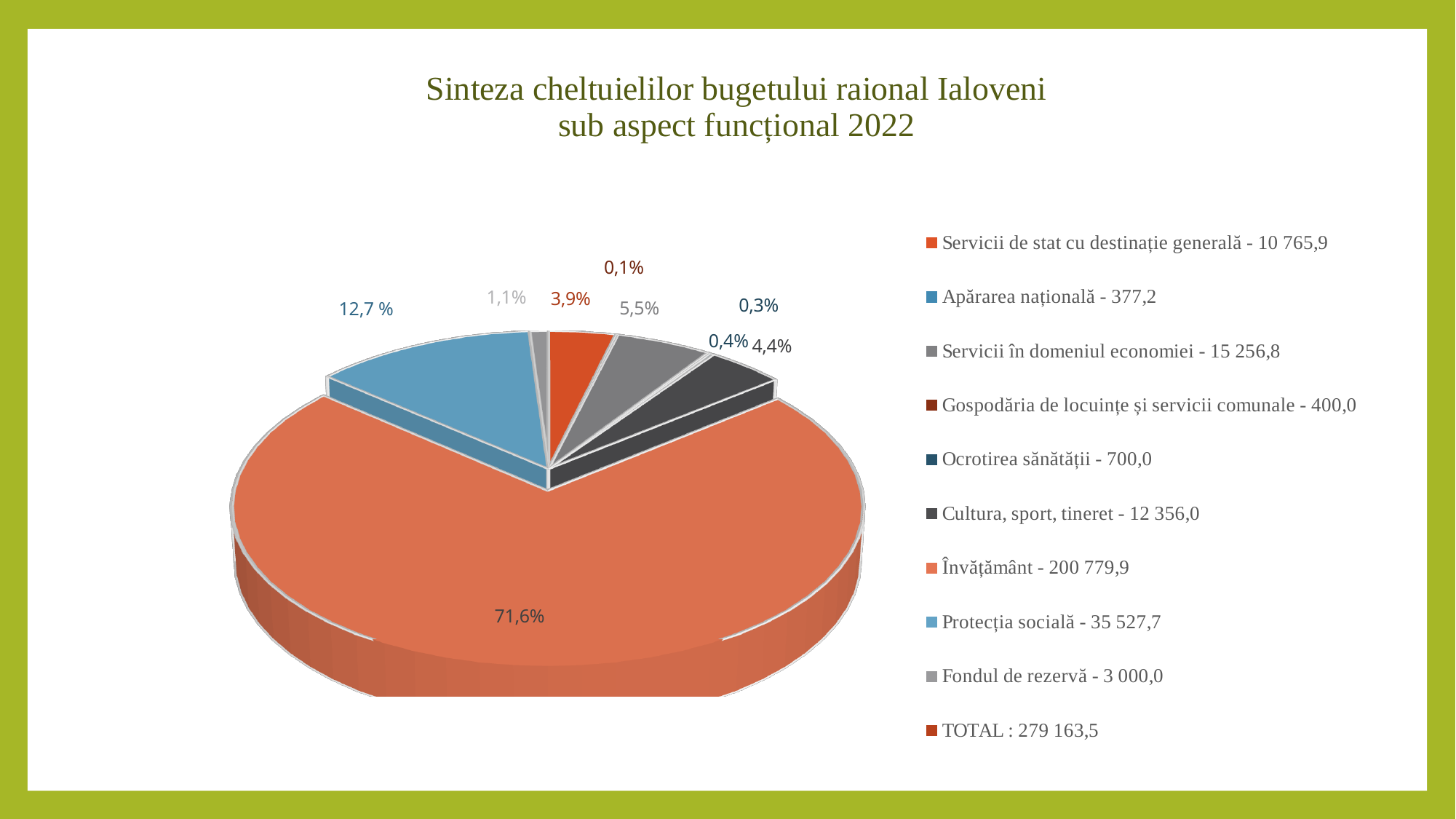
Which category has the smallest value in the legend? Apărarea națională What value is listed in the legend for Cultura, sport, tineret? 12 356,0 Which is larger: Servicii în domeniul economiei or Servicii de stat cu destinație generală? Servicii în domeniul economiei What percentage is shown on the largest slice of the pie? 71,6% What value is listed in the legend for Fondul de rezervă? 3 000,0 How many entries does the legend list? 10 What is the title of the chart on the slide? Sinteza cheltuielilor bugetului raional Ialoveni sub aspect funcțional 2022 What is the TOTAL value shown in the legend? 279 163,5 What percentage share is shown for the blue Protecția socială slice? 12,7 % What value is listed in the legend for Protecția socială? 35 527,7 Which category has the largest share of the pie? Învățământ What kind of chart is shown on the slide? pie chart